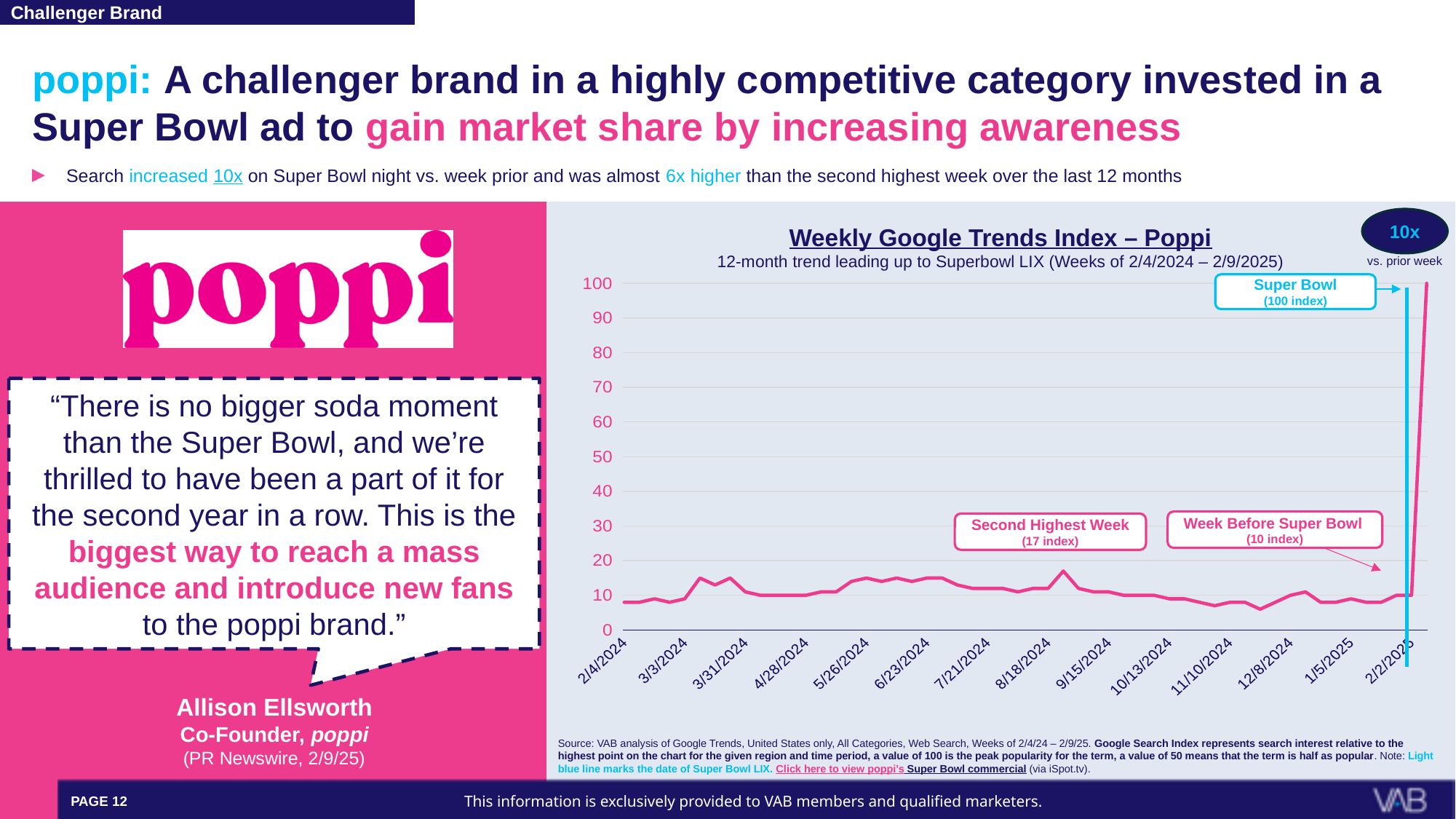
What is the difference between the Super Bowl week index and the second highest week? 83 Which is larger, the index for the Super Bowl week or the second highest week? Super Bowl week What is the index value for the second highest week? 17 What is the Google Trends index value for the Super Bowl week? 100 What is the difference between the Super Bowl week index and the week before the Super Bowl? 90 What does the light blue vertical line on the chart mark? The date of Super Bowl LIX Which week has the highest index value on the chart? Super Bowl week What is the title of the chart? Weekly Google Trends Index – Poppi Is the index value for the week of 6/23/2024 greater or less than 30? less What kind of chart is shown on the slide? Line chart What is the index value for the week before the Super Bowl? 10 Is the index value for the week of 2/4/2024 greater or less than 20? less